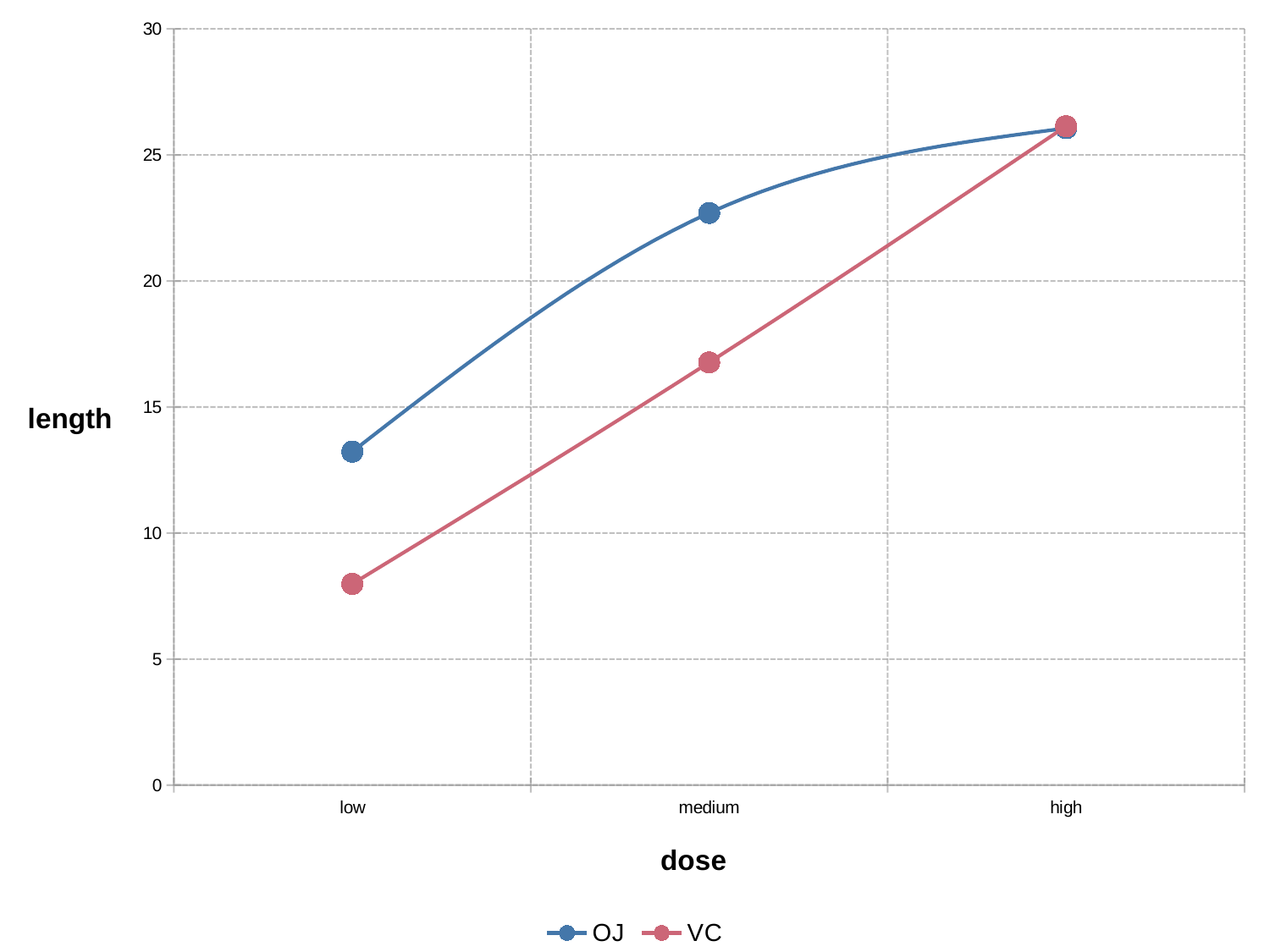
Do the values for the OJ series rise or fall from low to high dose? rise What kind of chart is shown on the slide? line chart How many dose categories are shown on the x axis? 3 Do the values for the VC series rise or fall from low to high dose? rise At the low dose, which series has the larger length, OJ or VC? OJ How many series does the legend list? 2 Is the length for VC at the low dose greater or less than 10? less Is the length for OJ at the medium dose greater or less than 20? greater Which dose has the lowest length for the VC series? low What is the label of the y axis? length Is the length for VC at the medium dose greater or less than 20? less At the medium dose, which series has the larger length, OJ or VC? OJ